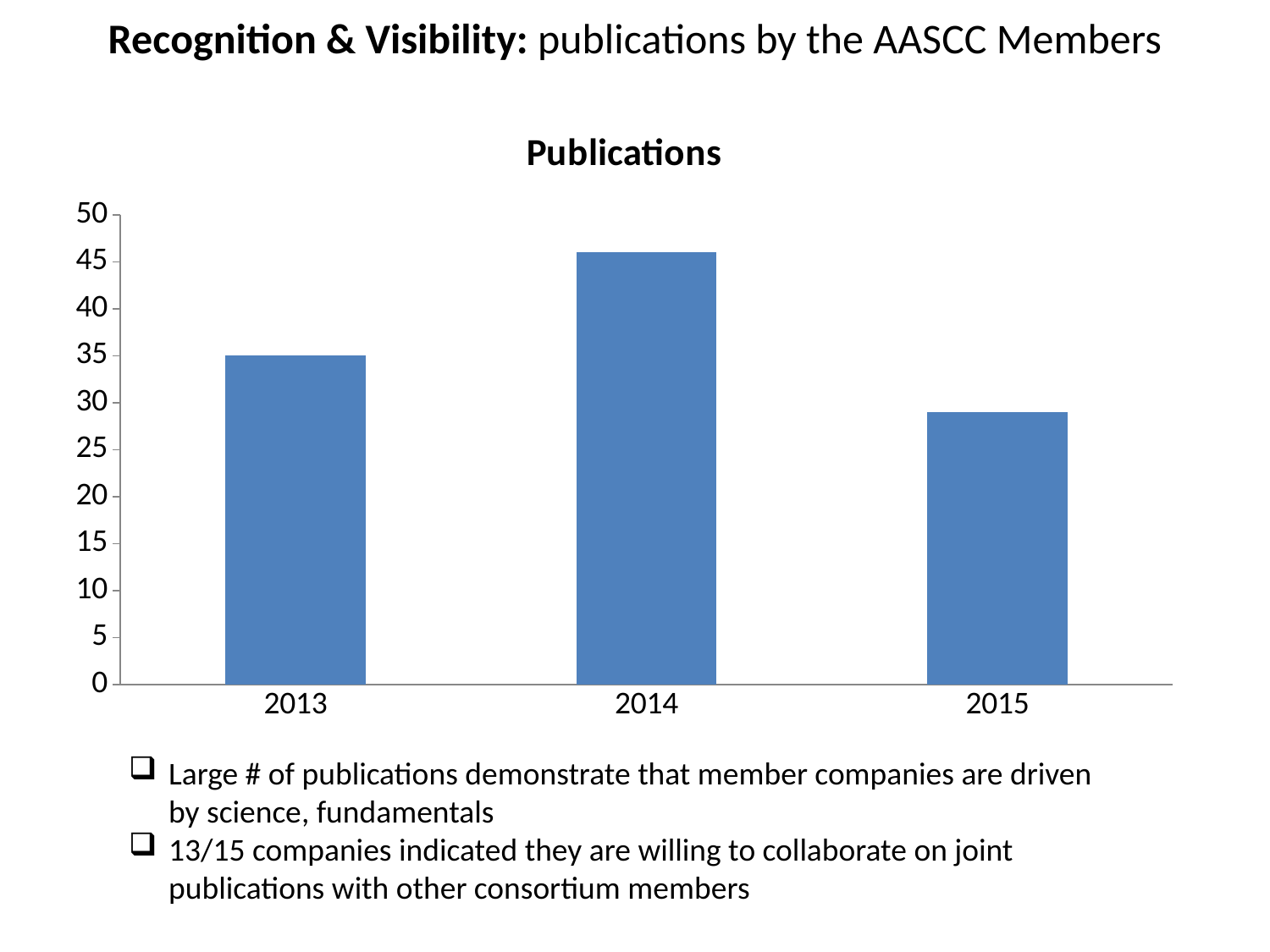
Is the value for 2014 greater or less than 50? less How many years are shown on the x axis of the chart? 3 What type of chart is shown on the slide? bar chart Do the publication values rise or fall from 2014 to 2015? fall Which year has more publications, 2013 or 2014? 2014 Which year has the highest number of publications? 2014 What is the title of the chart? Publications Which year has the lowest number of publications? 2015 What is the value for 2013 in the Publications chart? 35 Which year has more publications, 2013 or 2015? 2013